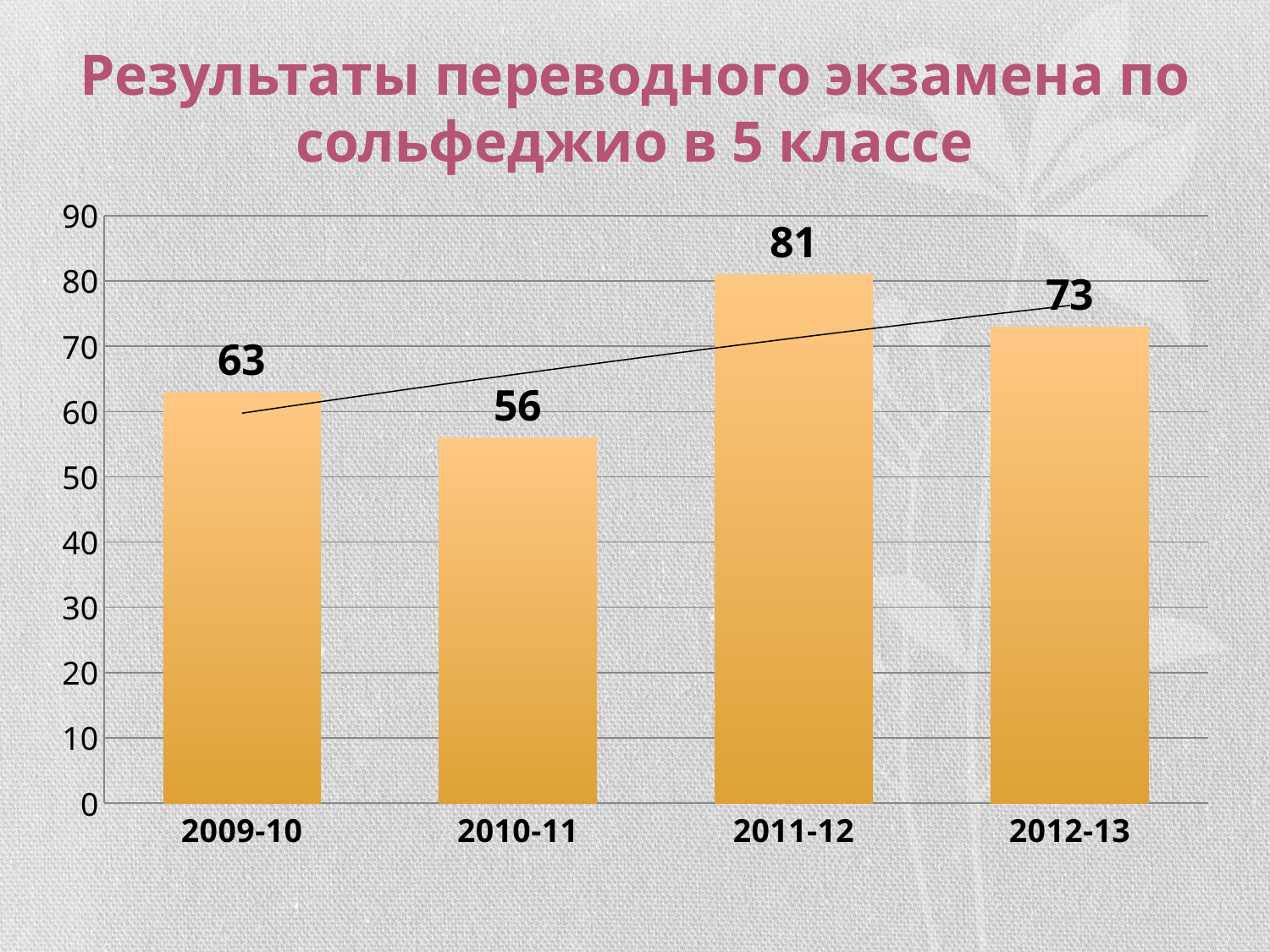
What is the value for 2012-13? 73 Is the value for 2011-12 greater or less than 80? greater Which year has the highest value? 2011-12 What is the title of the chart? Результаты переводного экзамена по сольфеджио в 5 классе How many years are shown on the x axis? 4 What is the value for 2011-12? 81 What kind of chart is this? bar chart What is the value for 2010-11? 56 Which year has the lowest value? 2010-11 Which is larger, the value for 2009-10 or the value for 2012-13? 2012-13 What is the difference between the values for 2011-12 and 2010-11? 25 What is the value for 2009-10? 63